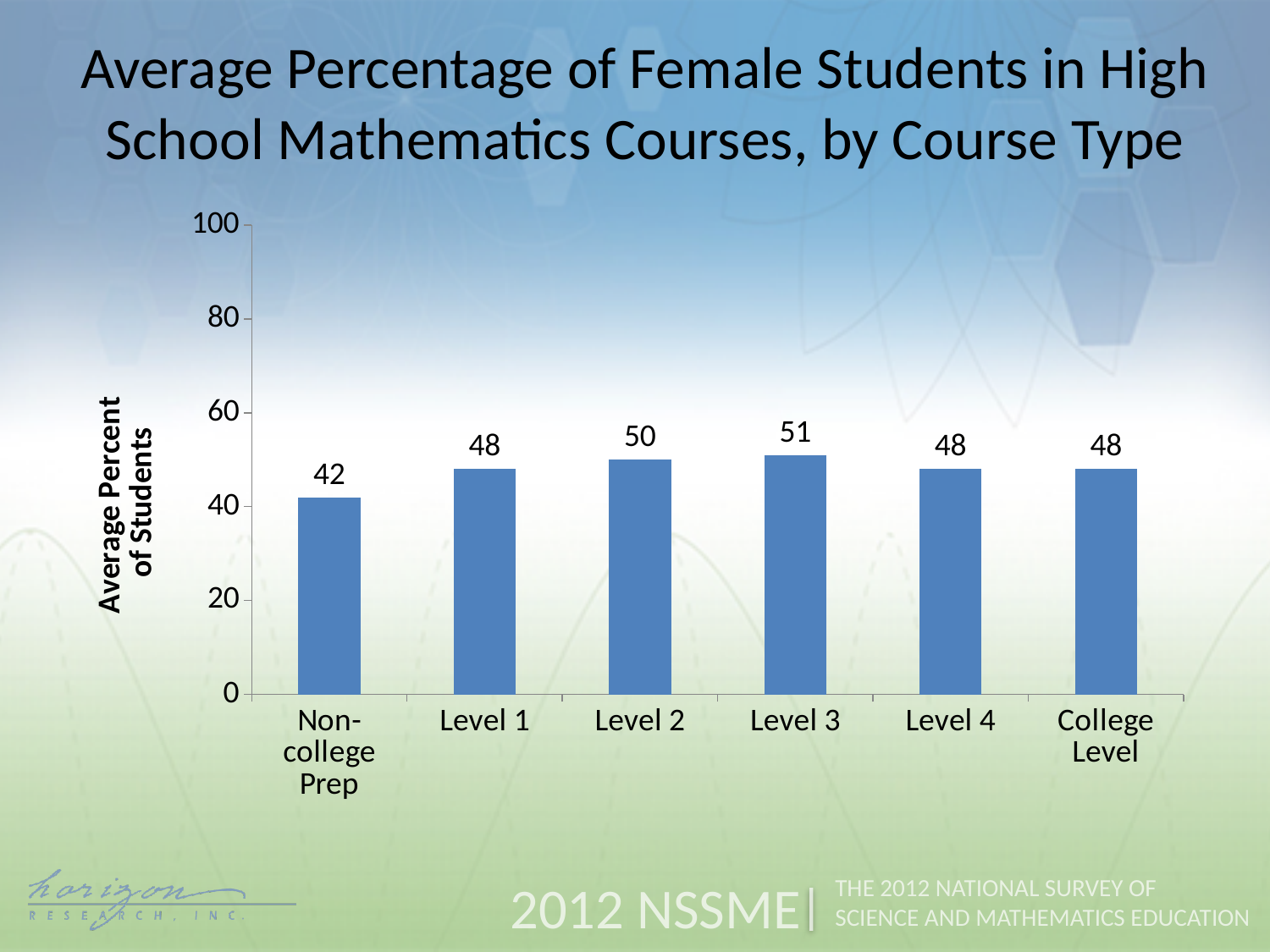
What is the average percent of female students in College Level courses? 48 What is the difference between the values for Level 3 and Non-college Prep? 9 What kind of chart is shown on the slide? bar chart Which is larger, the value for Level 2 or the value for Level 4? Level 2 What is the average percent of female students in Non-college Prep courses? 42 Which course type has the highest average percent of female students? Level 3 How many course types are shown on the chart? 6 Which course type has the lowest average percent of female students? Non-college Prep What is the average percent of female students in Level 2 courses? 50 What is the average percent of female students in Level 3 courses? 51 Is the value for Non-college Prep greater or less than 60? less What is the label of the vertical axis? Average Percent of Students